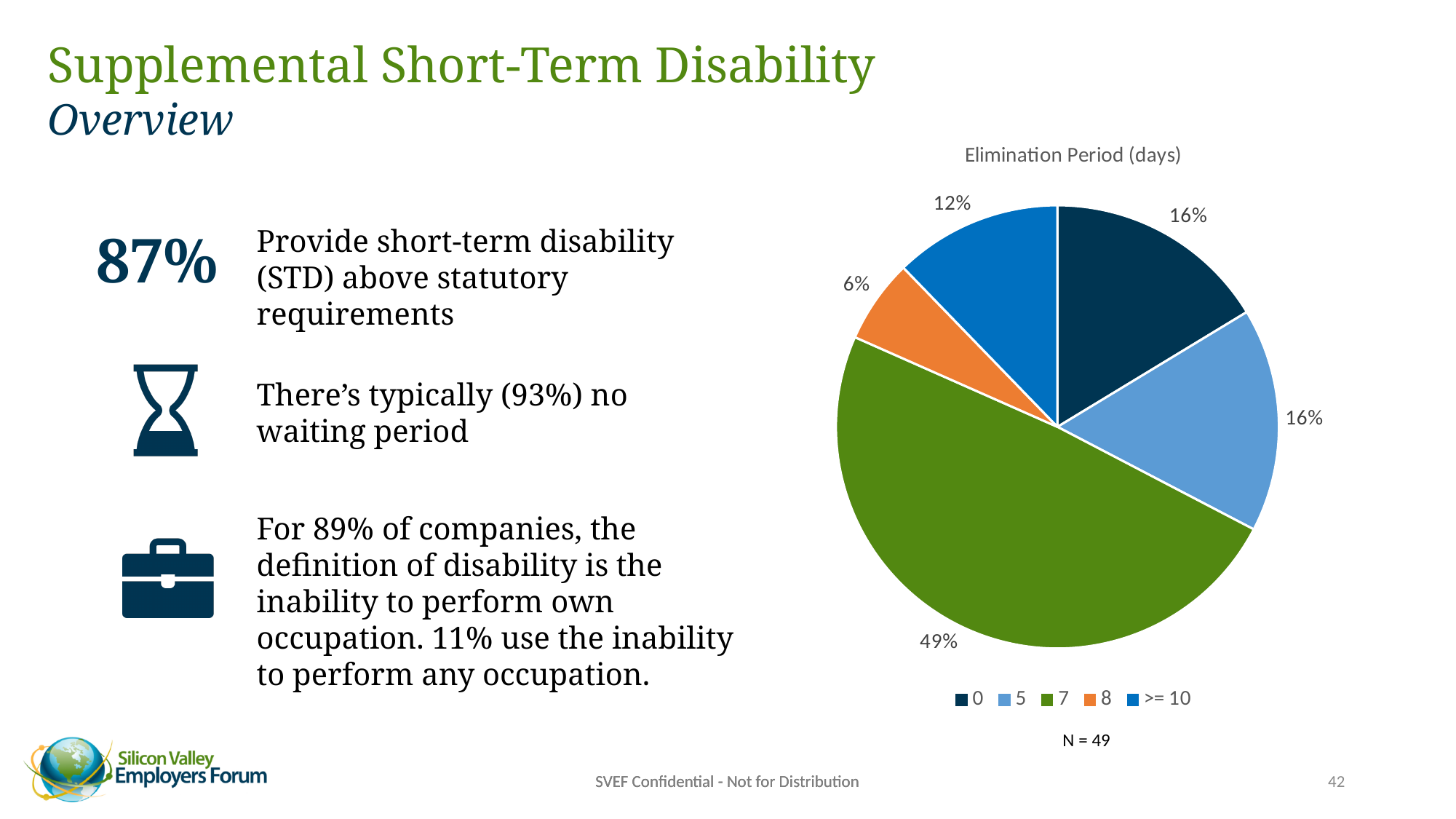
What share of the pie does the 7-day elimination period slice represent? 49% Which elimination period category has the largest slice of the pie? 7 What type of chart is shown on the slide? pie chart What is the difference in percentage points between the 7-day slice and the >= 10 days slice? 37 Which slice is larger, the 8-day slice or the >= 10 days slice? >= 10 What share of the pie does the 8-day elimination period slice represent? 6% How many categories does the legend of the pie chart list? 5 Which elimination period category has the smallest slice of the pie? 8 What is the title of the chart? Elimination Period (days) What share of the pie does the 0-day elimination period slice represent? 16% What is the sample size (N) shown below the pie chart? N = 49